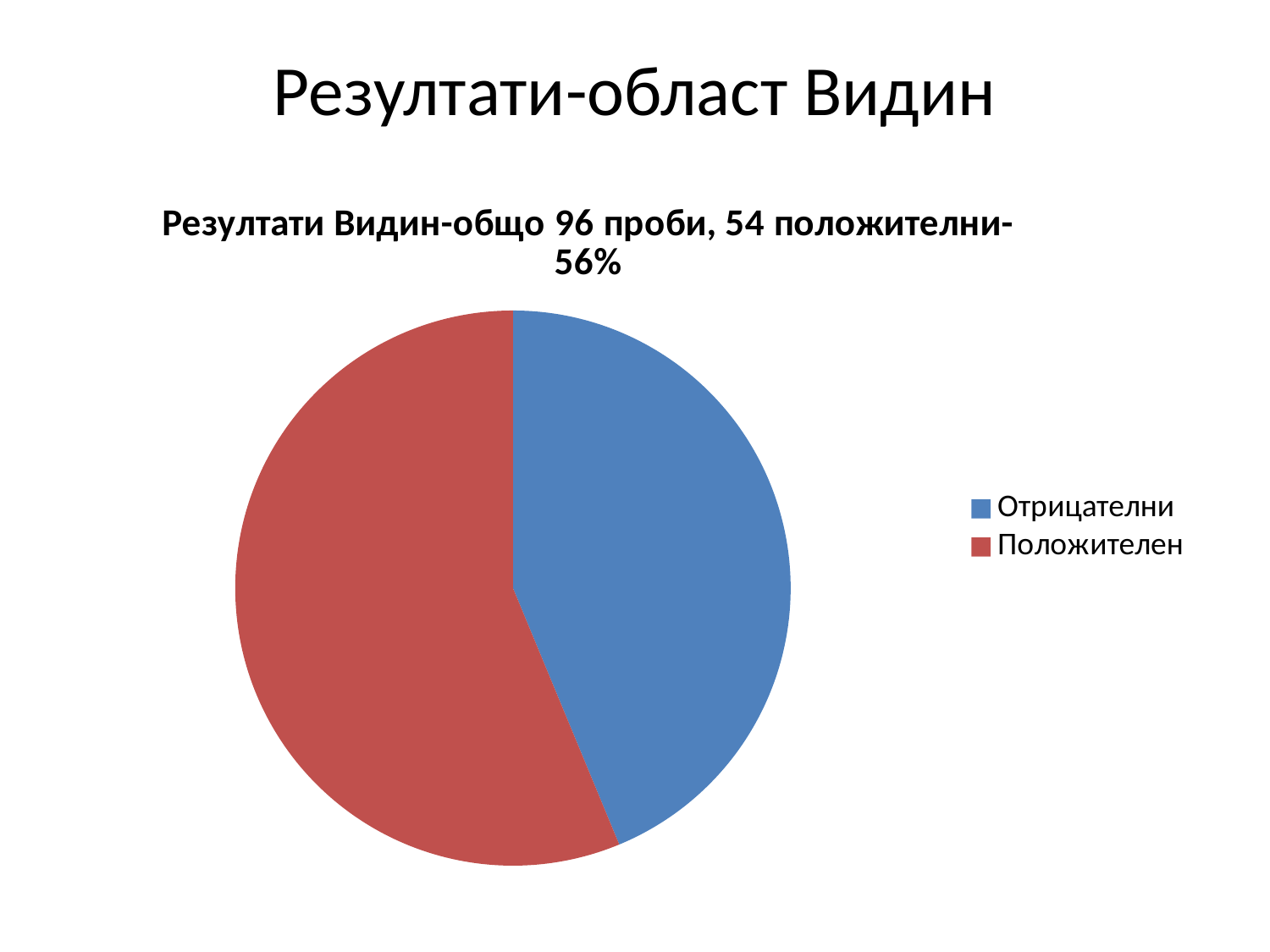
What kind of chart is shown on the slide? pie chart Is the share of the Положителен slice greater or less than 50%? greater What is the title of the pie chart? Резултати Видин-общо 96 проби, 54 положителни-56% What colour is the Отрицателни slice in the pie chart? blue Which slice of the pie chart is the smallest? Отрицателни According to the chart title, what share of the samples were positive (Положителен)? 56% Which slice of the pie chart is the largest? Положителен According to the chart title, how many samples were positive? 54 Which slice is larger, Отрицателни or Положителен? Положителен According to the chart title, how many samples in total were tested in Видин? 96 How many entries does the legend of the pie chart list? 2 How many slices does the pie chart have? 2